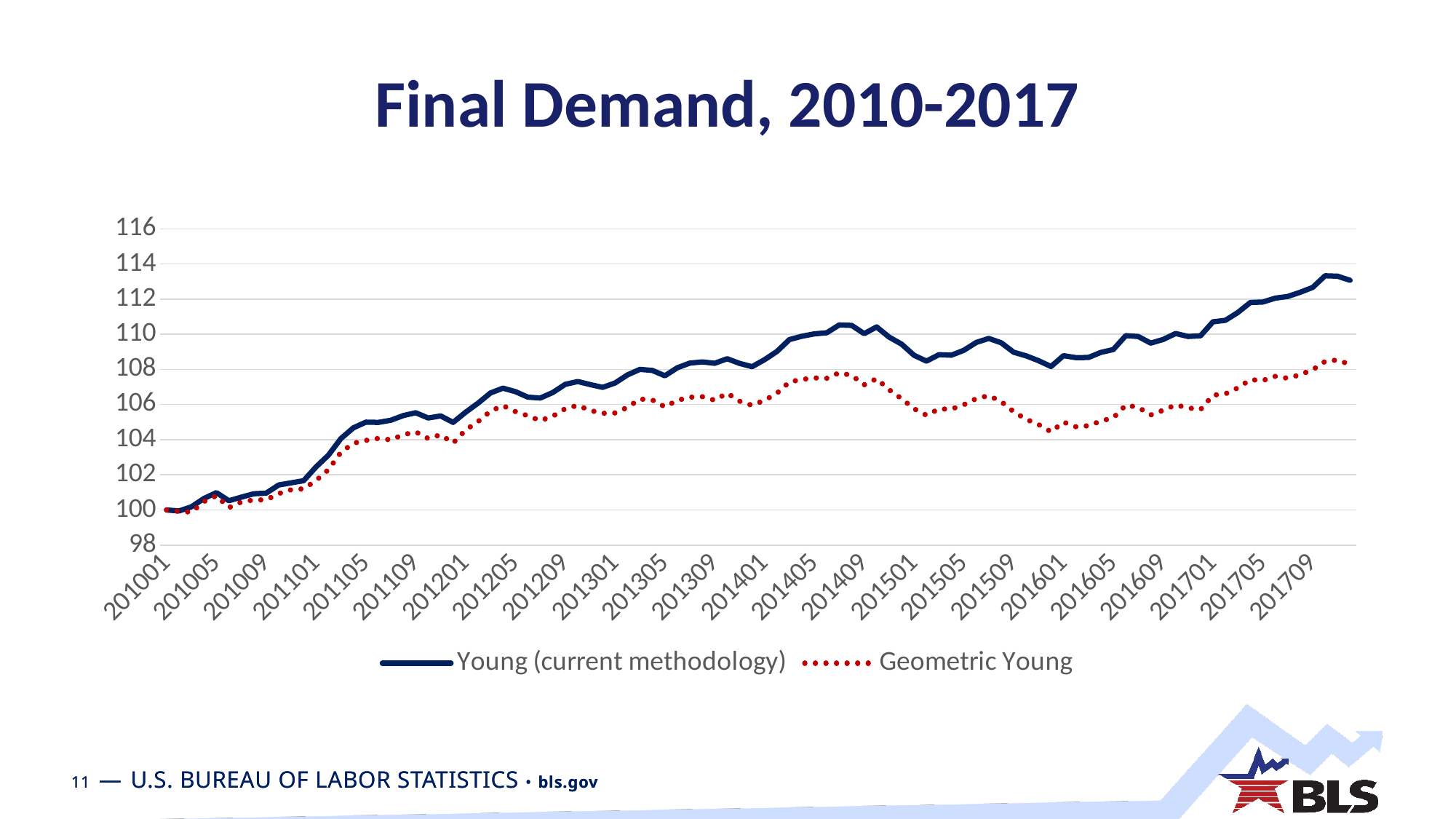
Is the value for Geometric Young at 201201 greater or less than 106? less Is the value for Young (current methodology) at 201101 greater or less than 104? less What is the title of the chart? Final Demand, 2010-2017 How many series does the legend list? 2 What kind of chart is shown on the slide? line chart Do the values of the Young (current methodology) series generally rise or fall from 201001 to 201709? rise Is the value for Young (current methodology) at 201705 greater or less than 110? greater Which series is drawn as a red dotted line? Geometric Young Which series is higher at 201409, Young (current methodology) or Geometric Young? Young (current methodology) Which series is higher at 201705, Young (current methodology) or Geometric Young? Young (current methodology)